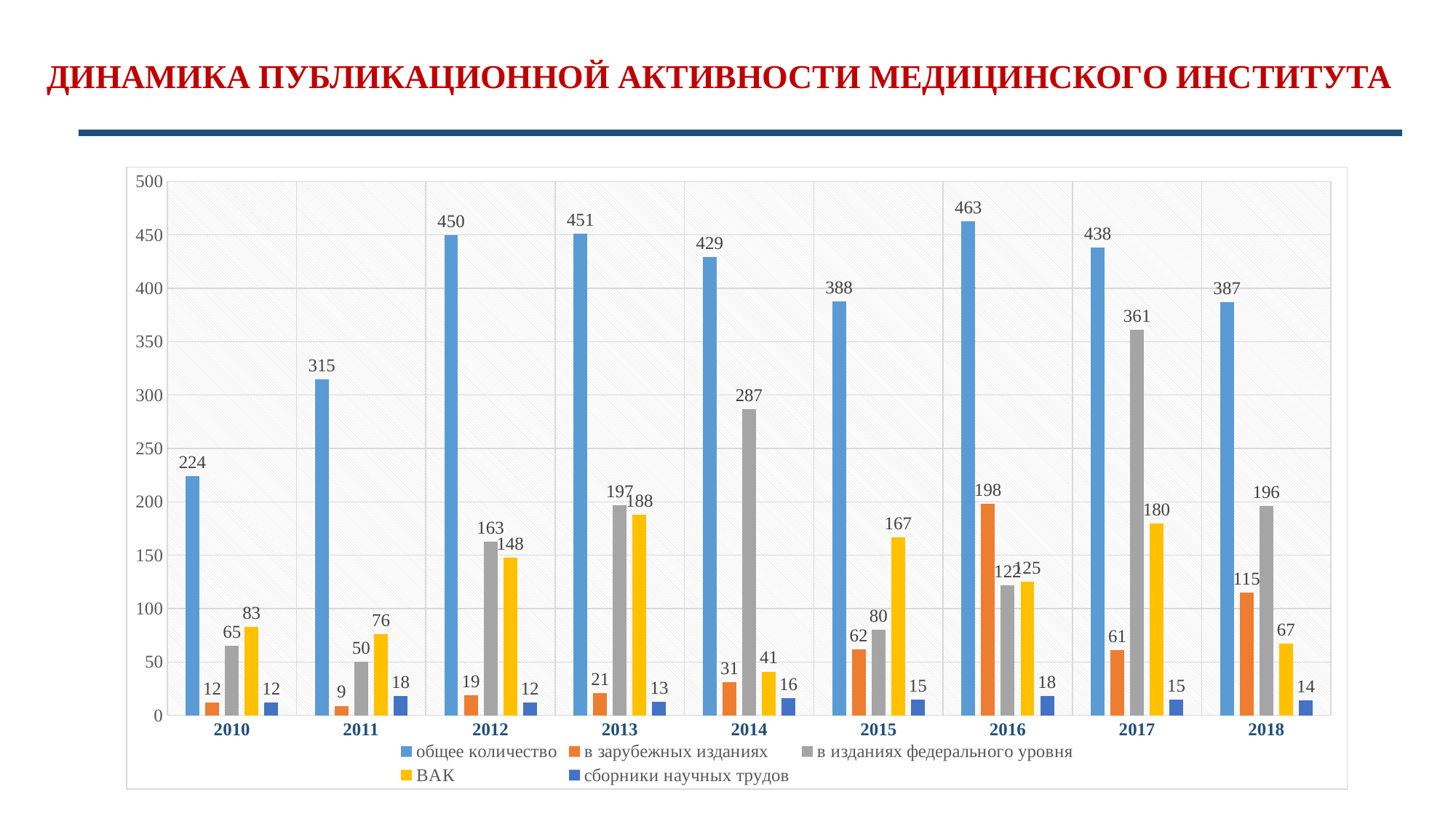
What is the value of 'общее количество' for 2016? 463 Which is larger in 2014: 'в изданиях федерального уровня' or 'ВАК'? в изданиях федерального уровня How many series does the legend list? 5 Does 'общее количество' rise or fall from 2010 to 2013? rise How many years are shown on the x axis? 9 What type of chart is shown on the slide? bar chart In which year is 'в зарубежных изданиях' the lowest? 2011 What is the value of 'в изданиях федерального уровня' for 2017? 361 What is the title of the chart on the slide? ДИНАМИКА ПУБЛИКАЦИОННОЙ АКТИВНОСТИ МЕДИЦИНСКОГО ИНСТИТУТА What is the value of 'ВАК' for 2013? 188 In which year is 'общее количество' the highest? 2016 What is the difference between 'общее количество' in 2012 and in 2010? 226